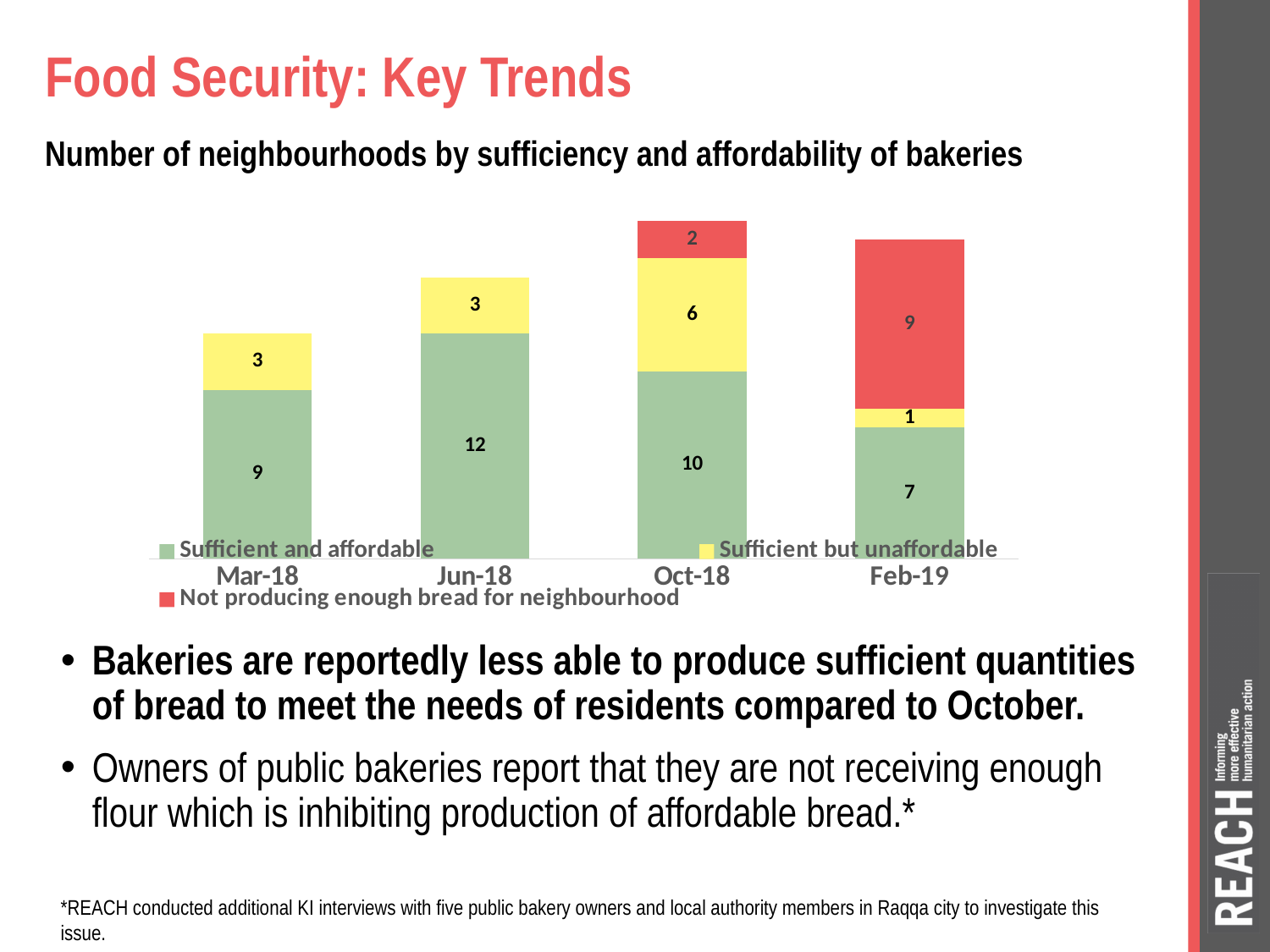
What is the value for 'Sufficient but unaffordable' in Oct-18? 6 What is the value for 'Sufficient and affordable' in Jun-18? 12 What is the total number of neighbourhoods in the Oct-18 bar? 18 In which period is the 'Sufficient and affordable' value lowest? Feb-19 How many time periods are shown on the x axis? 4 What is the difference between the 'Not producing enough bread for neighbourhood' values in Feb-19 and Oct-18? 7 How many series does the legend list? 3 What kind of chart is shown on the slide? Stacked bar chart Which is larger: the 'Sufficient but unaffordable' value in Oct-18 or in Feb-19? Oct-18 What is the value for 'Not producing enough bread for neighbourhood' in Feb-19? 9 In which period is the 'Sufficient and affordable' value highest? Jun-18 Which colour represents 'Not producing enough bread for neighbourhood' in the chart? Red